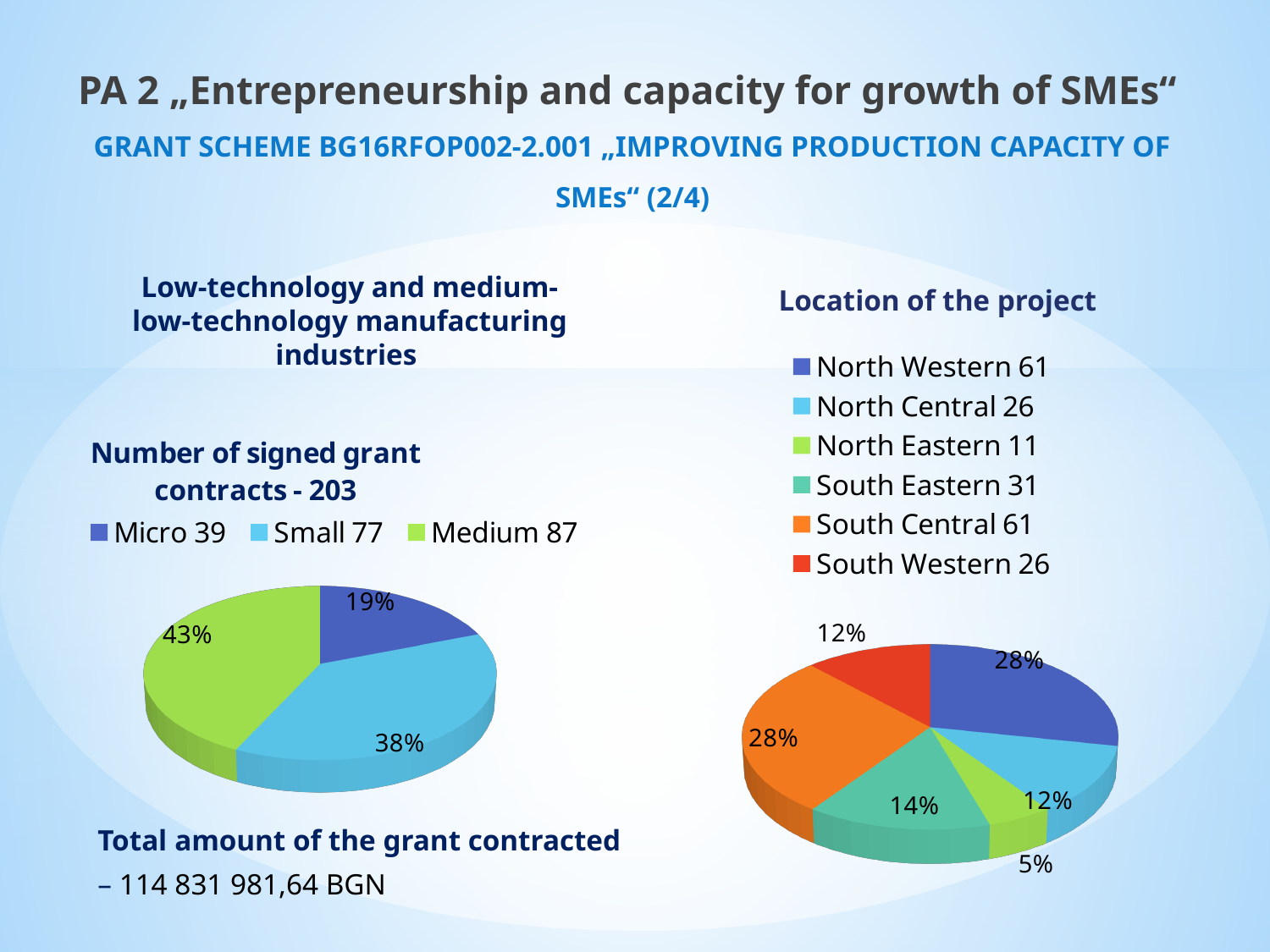
In the 'Number of signed grant contracts - 203' chart, what share of the pie does Small represent? 38% In the 'Location of the project' chart, what share of the pie does South Eastern represent? 14% In the 'Number of signed grant contracts - 203' chart, what share of the pie does Medium represent? 43% In the 'Number of signed grant contracts - 203' chart, which category has the smallest share? Micro In the 'Number of signed grant contracts - 203' chart, what is the difference between the Medium and Small contract counts? 10 In the 'Location of the project' chart, which is larger, South Eastern or North Central? South Eastern In the 'Location of the project' chart, how many regions are listed in the legend? 6 What type of chart is used for 'Number of signed grant contracts - 203'? pie chart In the 'Location of the project' chart, what colour is the South Central slice? orange In the 'Location of the project' chart, which region has the smallest share? North Eastern In the 'Number of signed grant contracts - 203' chart, how many categories are shown? 3 In the 'Number of signed grant contracts - 203' chart, how many contracts does the legend give for Micro? 39